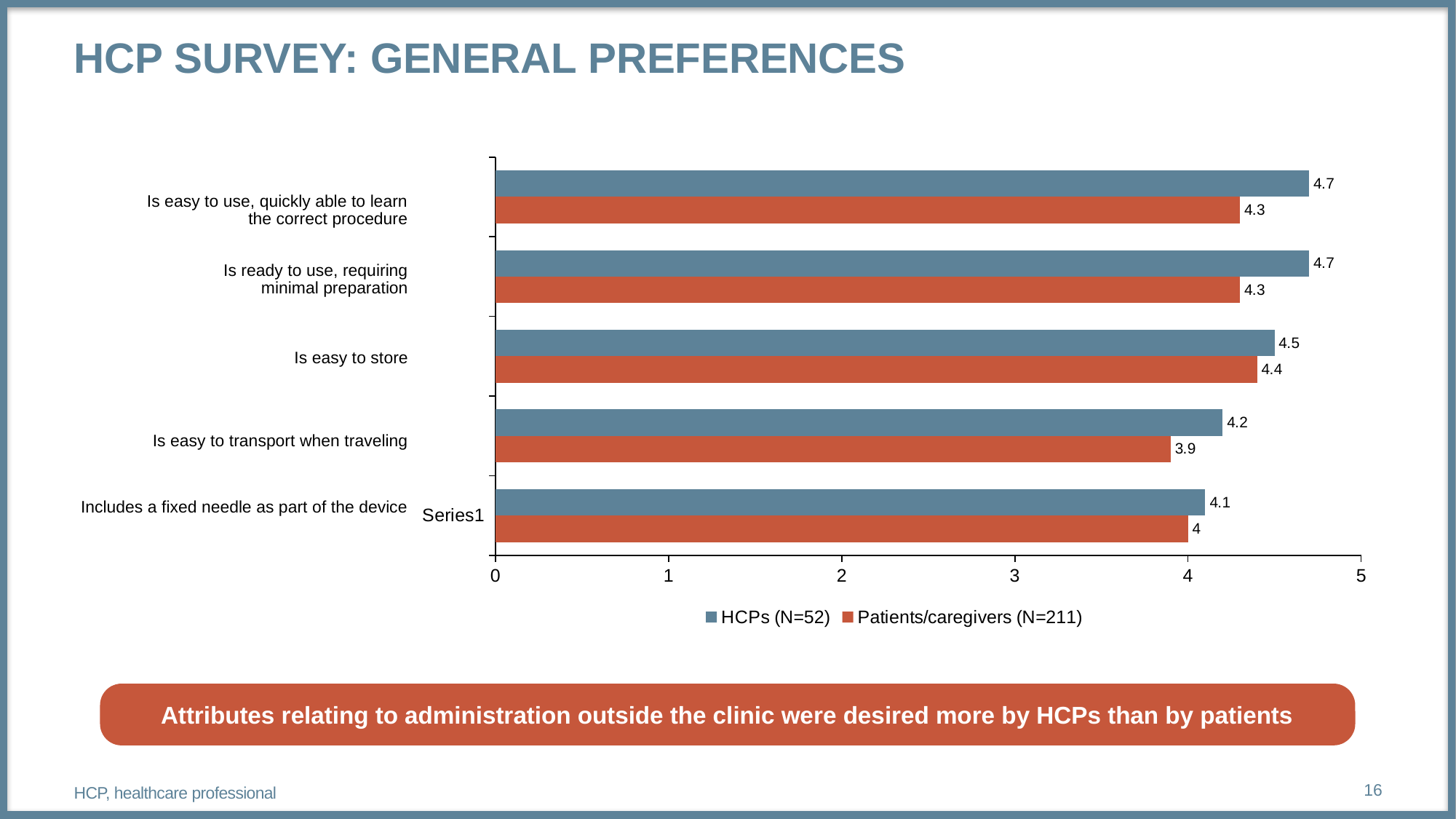
Which category has the lowest HCPs (N=52) value? Includes a fixed needle as part of the device How many categories are shown on the chart? 5 What is the HCPs (N=52) value for "Is ready to use, requiring minimal preparation"? 4.7 What kind of chart is shown on the slide? Bar chart Which category has the highest Patients/caregivers (N=211) value? Is easy to store What is the difference between the HCPs (N=52) and Patients/caregivers (N=211) values for "Is easy to use, quickly able to learn the correct procedure"? 0.4 What is the HCPs (N=52) value for "Is easy to store"? 4.5 For "Is easy to transport when traveling", which series has the larger value: HCPs (N=52) or Patients/caregivers (N=211)? HCPs (N=52) What colour are the bars for the Patients/caregivers (N=211) series? Orange-red What is the Patients/caregivers (N=211) value for "Includes a fixed needle as part of the device"? 4 What is the Patients/caregivers (N=211) value for "Is easy to transport when traveling"? 3.9 How many series does the legend list? 2